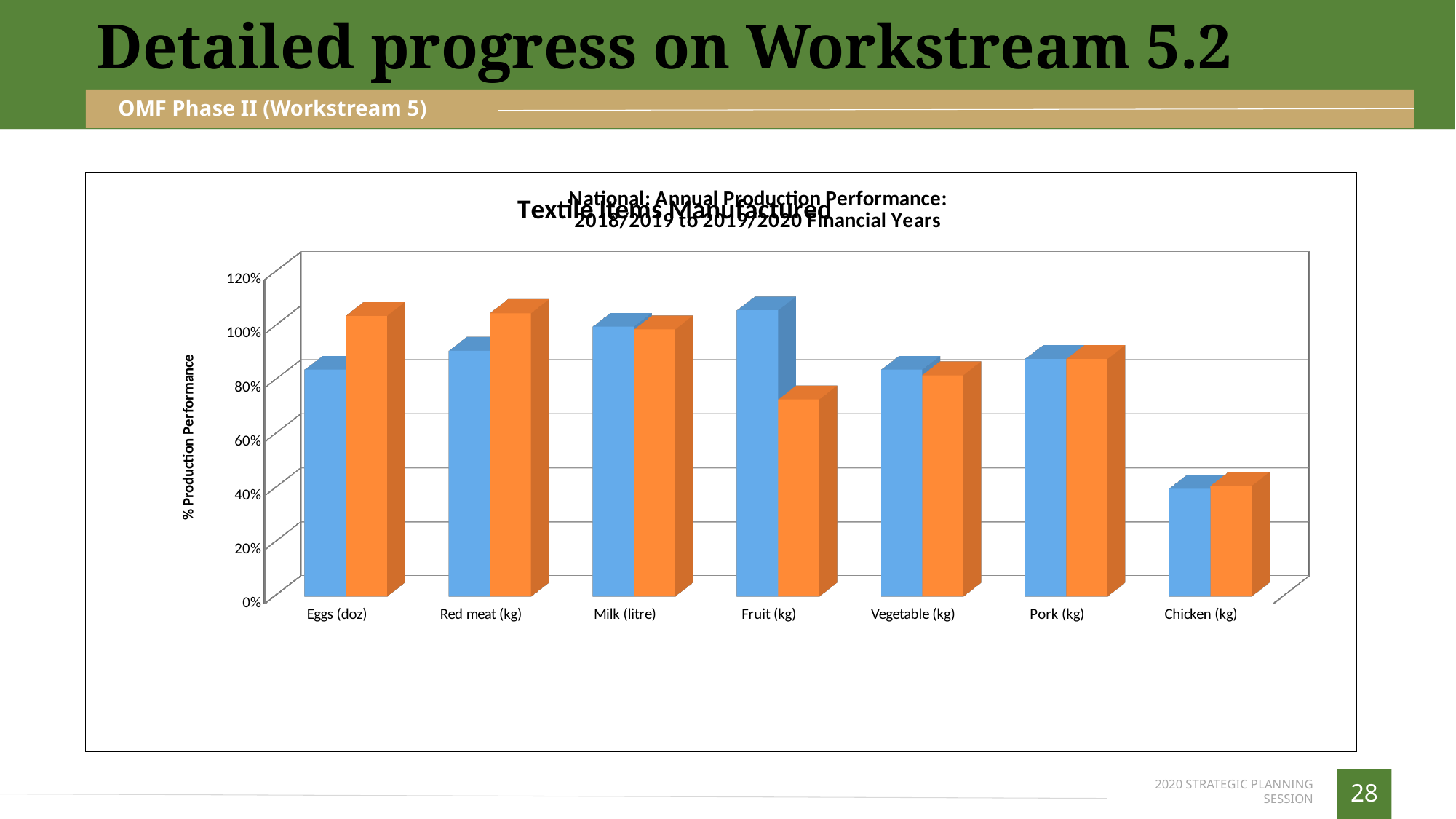
What is the highest value shown on the vertical axis of the chart? 120% Which category has the lowest bars in the chart? Chicken (kg) Is the blue bar for Chicken (kg) greater or less than 60%? less Is the orange bar for Eggs (doz) greater or less than 80%? greater What is the label on the vertical axis of the chart? % Production Performance What kind of chart is shown on the slide? bar chart Is the orange bar for Red meat (kg) greater or less than 80%? greater For Eggs (doz), which bar is taller, the blue one or the orange one? orange Which category has the taller blue bar, Pork (kg) or Chicken (kg)? Pork (kg) How many categories are shown on the x axis of the chart? 7 For Fruit (kg), which bar is taller, the blue one or the orange one? blue